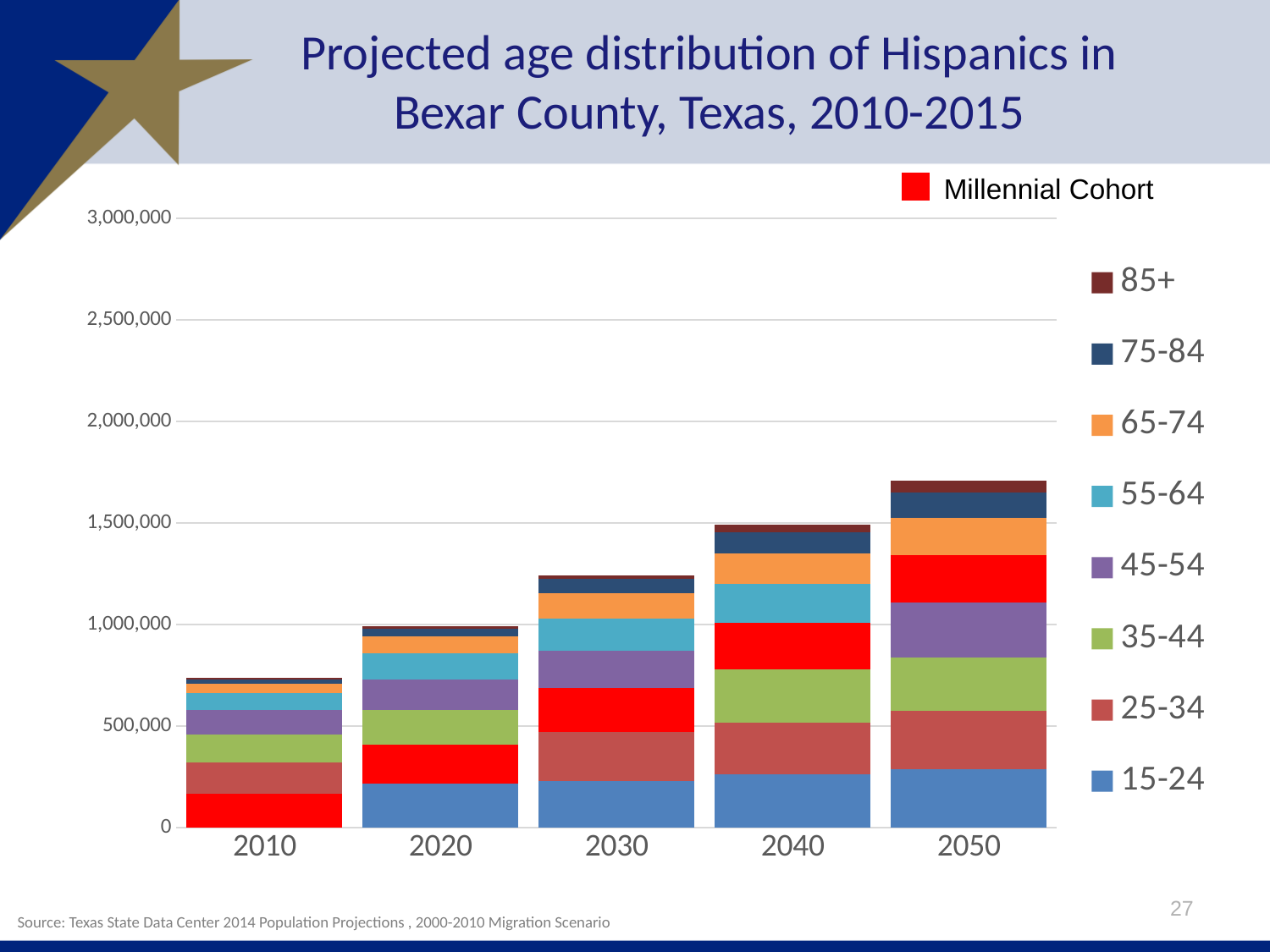
Do the total bar heights rise or fall from 2010 to 2050? Rise What kind of chart is shown on the slide? Stacked bar chart How many age groups does the legend list? 8 Which year has the tallest stacked bar? 2050 How many years are shown along the x axis of the chart? 5 Is the total for 2050 greater or less than 1,500,000? greater What label is given to the red segment in the chart's annotation? Millennial Cohort Which year has the larger total bar, 2020 or 2040? 2040 Is the total for 2030 greater or less than 1,000,000? greater Which year has the shortest stacked bar? 2010 Is the total for 2010 greater or less than 1,000,000? less Which age group is at the bottom of each stacked bar? 15-24